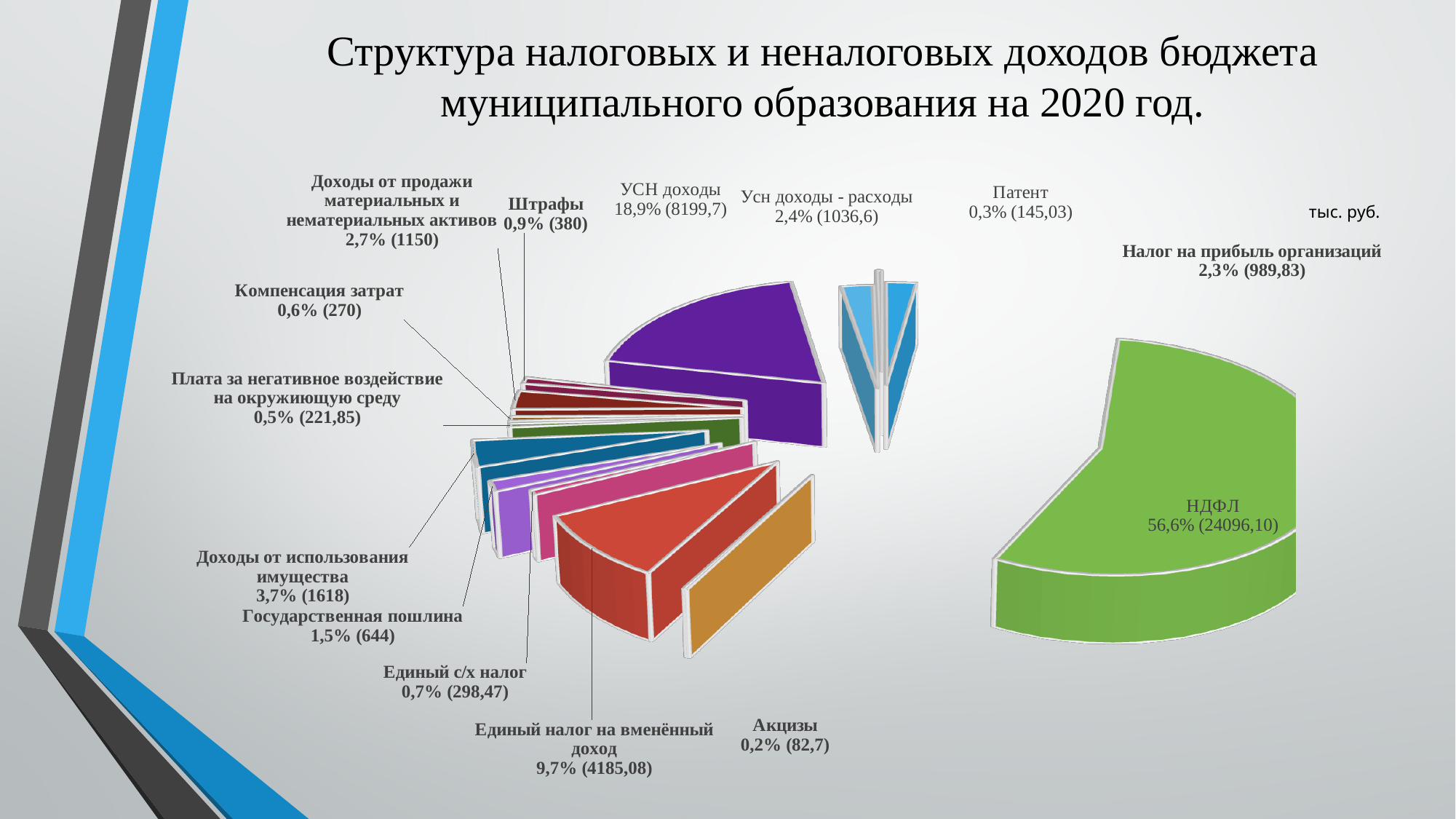
How many categories are shown in the pie chart? 14 Which is larger: Штрафы or Компенсация затрат? Штрафы Which category has the largest share of the budget revenues? НДФЛ What share of revenues does Патент account for? 0,3% What is the value shown for УСН доходы? 8199,7 What is the value shown for Государственная пошлина? 644 In what units are the values in parentheses given? тыс. руб. Which category has the smallest share of the budget revenues? Акцизы What share of revenues does НДФЛ account for? 56,6% What kind of chart is shown on the slide? Pie chart What is the difference in percentage points between УСН доходы (18,9%) and Единый налог на вменённый доход (9,7%)? 9,2% What is the value shown for Единый налог на вменённый доход? 4185,08